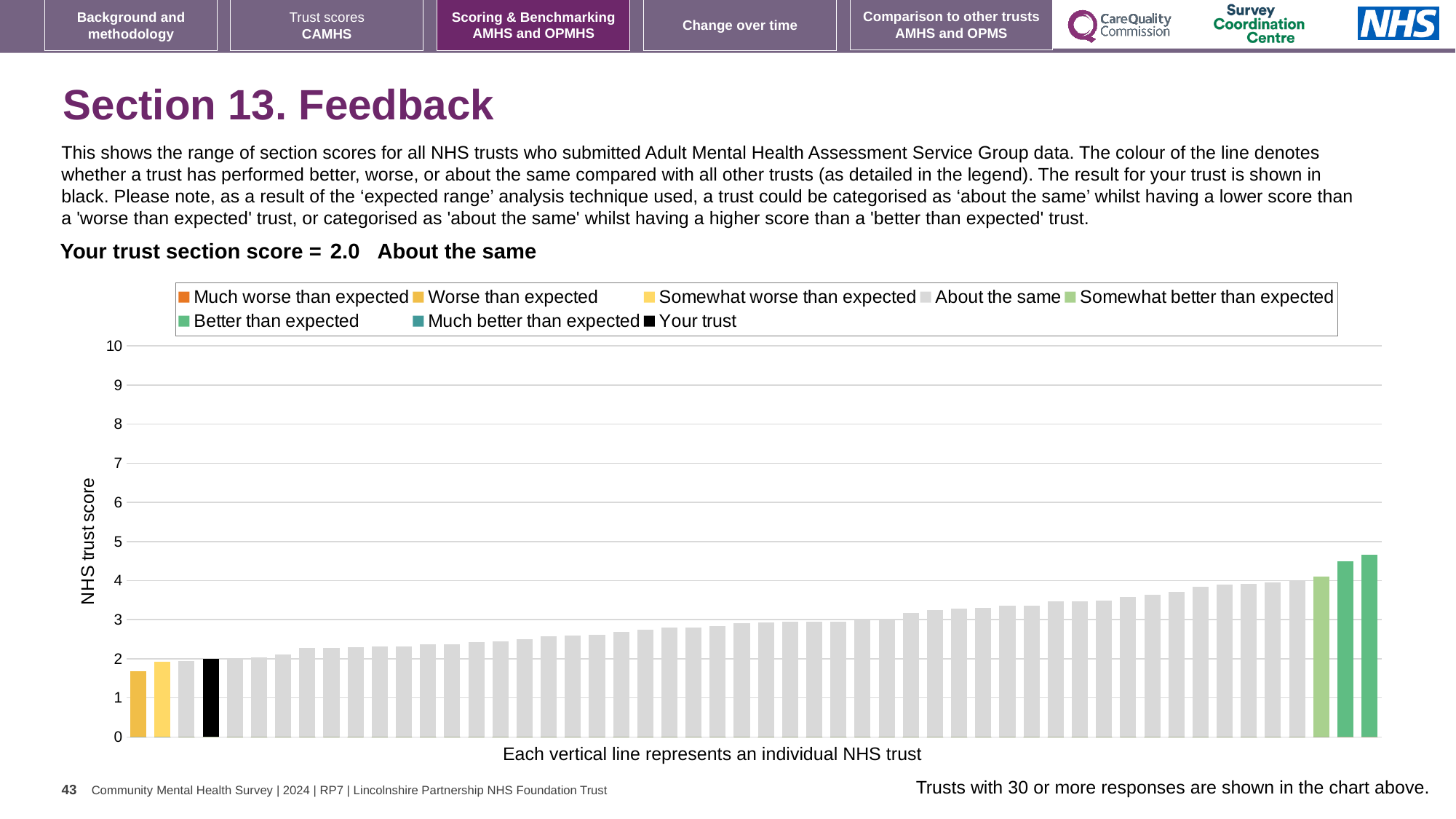
Which category is your trust's section score placed in? About the same What is the label of the y axis? NHS trust score How many bars are coloured green (better than expected categories) in the chart? 3 Is the value of the tallest bar in the chart greater or less than 4? greater Is the value of the leftmost bar in the chart greater or less than 2? less What is the highest value shown on the y axis? 10 How many entries does the chart legend list? 8 Is the value of the black 'Your trust' bar greater or less than 3? less What kind of chart is shown on the slide? bar chart What is the section score for your trust? 2.0 Do the bar values rise or fall moving from left to right along the x axis? rise